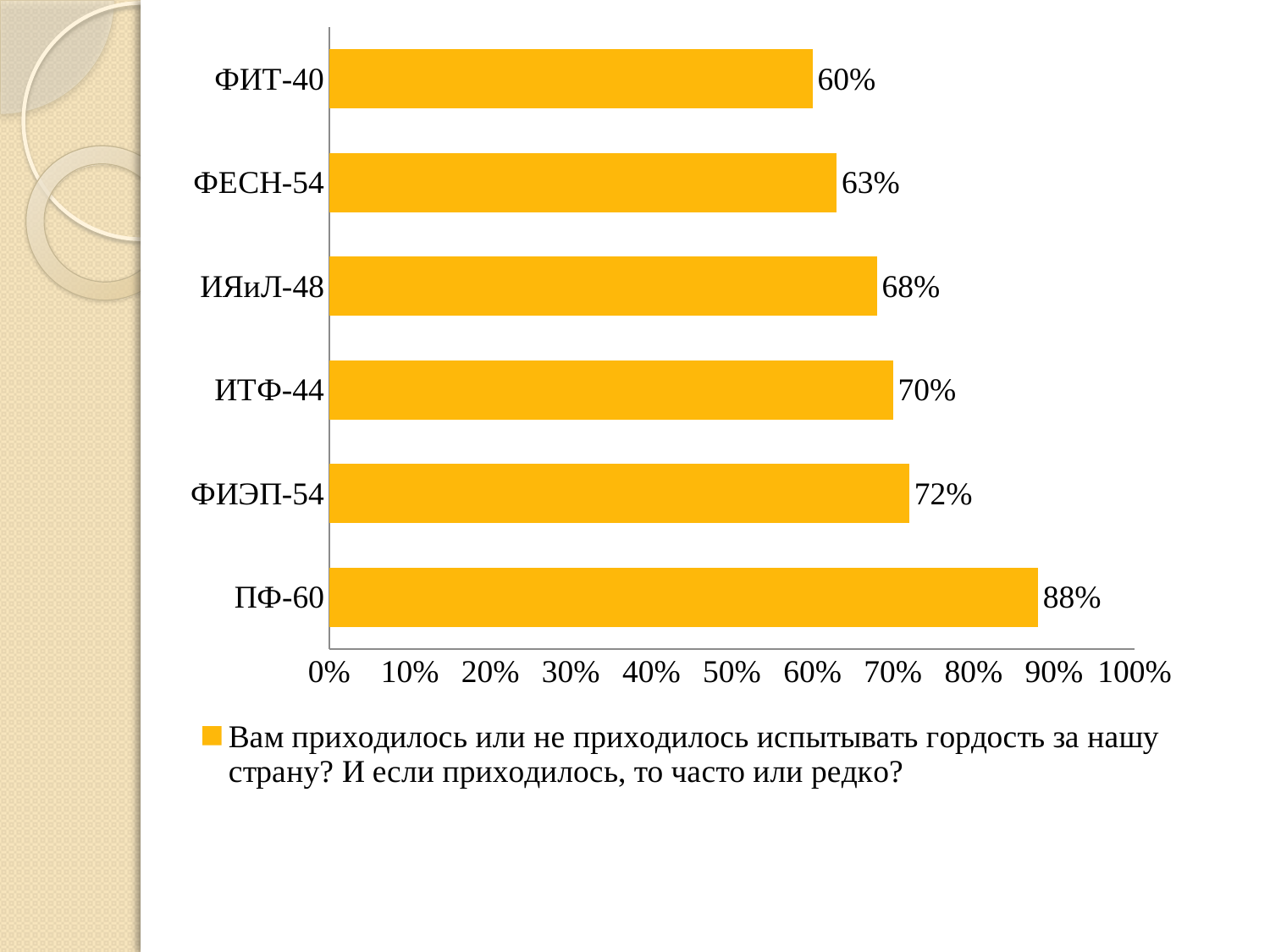
How many series does the legend list? 1 What is the difference between the values for ФЕСН-54 and ФИТ-40? 3% What kind of chart is shown on the slide? bar chart Which is larger, the value for ИТФ-44 or the value for ФЕСН-54? ИТФ-44 What is the value for ПФ-60? 88% Which category has the highest value? ПФ-60 How many categories are shown in the chart? 6 Is the value for ИЯиЛ-48 greater or less than 50%? greater What is the value for ФИТ-40? 60% Which category has the lowest value? ФИТ-40 What is the difference between the values for ПФ-60 and ФИЭП-54? 16% What is the value for ИЯиЛ-48? 68%